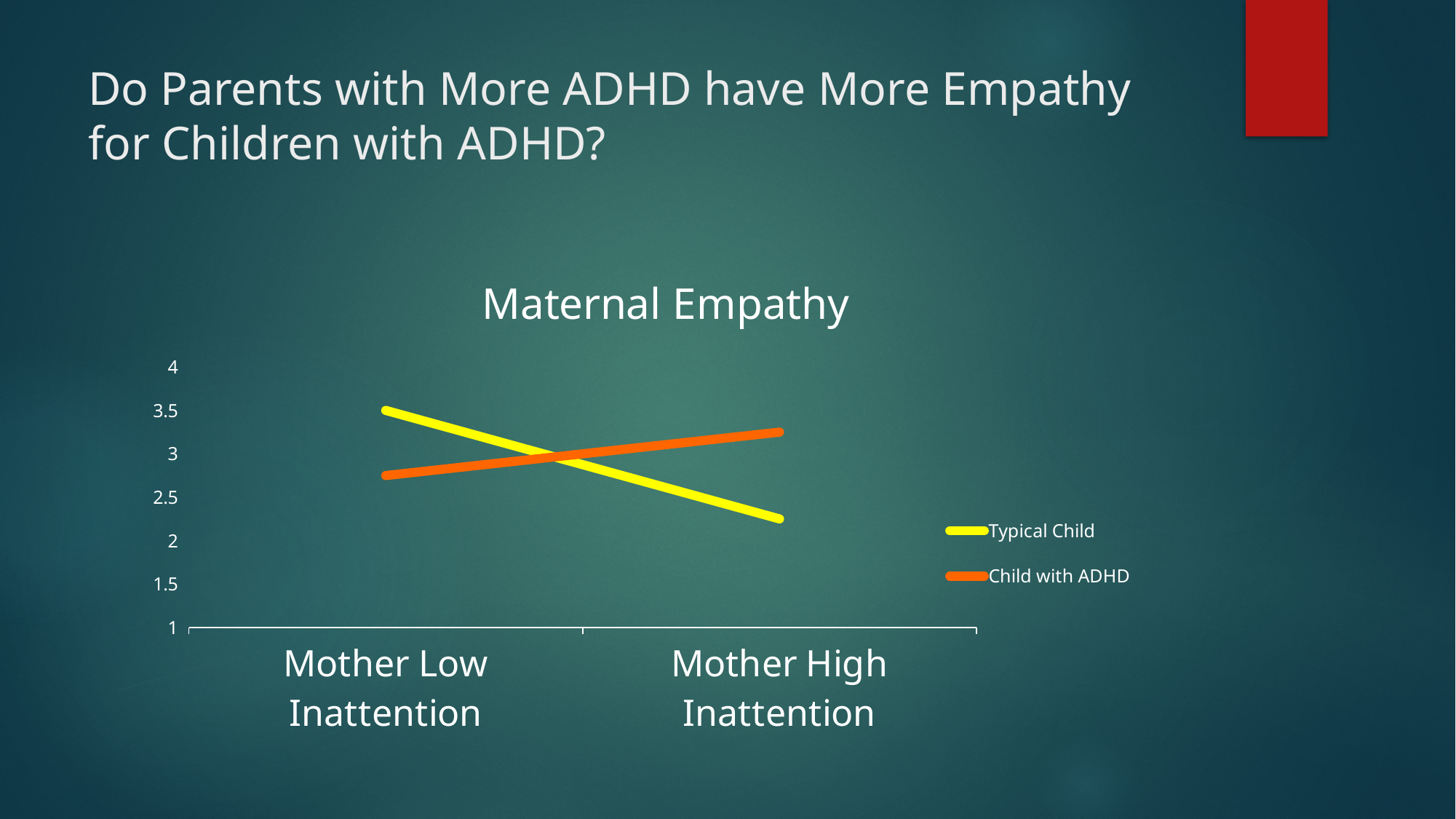
Does the Child with ADHD line rise or fall from Mother Low Inattention to Mother High Inattention? rise Does the Typical Child line rise or fall from Mother Low Inattention to Mother High Inattention? fall What is the title of the chart? Maternal Empathy Is the value for Typical Child at Mother High Inattention greater or less than 2.5? less Is the value for Child with ADHD at Mother High Inattention greater or less than 3? greater At Mother Low Inattention, which series has the higher value, Typical Child or Child with ADHD? Typical Child What kind of chart is shown on the slide? line chart How many series does the legend list? 2 Which colour is used for the Typical Child line? yellow Is the value for Child with ADHD at Mother Low Inattention greater or less than 3? less How many categories are shown on the x axis? 2 At Mother High Inattention, which series has the higher value, Typical Child or Child with ADHD? Child with ADHD